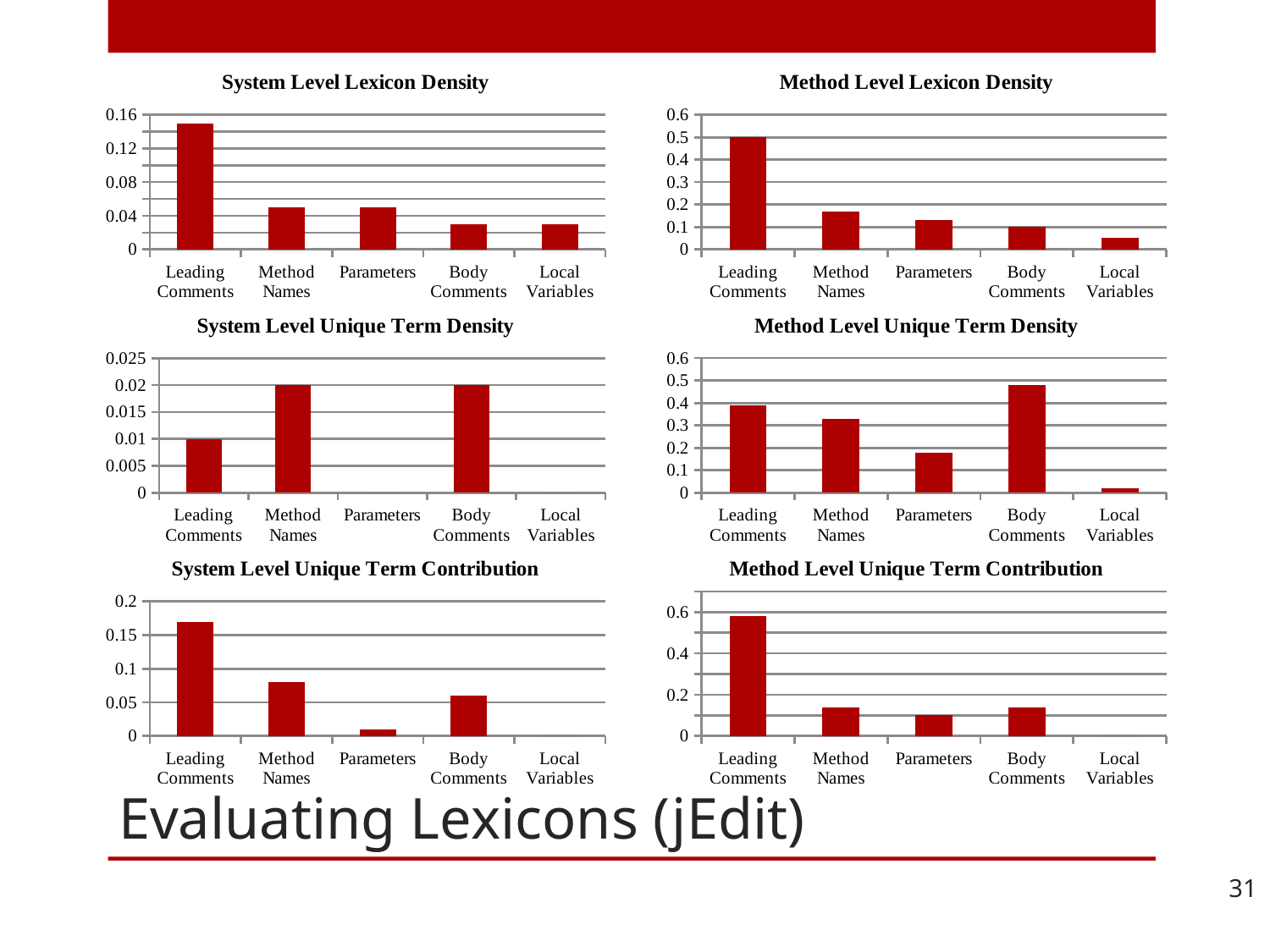
In the Method Level Unique Term Density chart, which category has the lowest value? Local Variables How many categories are shown on the x axis of the Method Level Lexicon Density chart? 5 In the System Level Unique Term Density chart, what is the difference between the values for Method Names and Leading Comments? 0.01 In the System Level Unique Term Contribution chart, is the value for Leading Comments greater or less than 0.15? greater In the Method Level Unique Term Density chart, which category has the highest value? Body Comments In the Method Level Lexicon Density chart, which category has the lowest value? Local Variables In the System Level Lexicon Density chart, which category has the highest value? Leading Comments What kind of chart is the System Level Lexicon Density chart? bar chart In the System Level Unique Term Density chart, what is the value for Leading Comments? 0.01 In the Method Level Lexicon Density chart, what is the value for Leading Comments? 0.5 In the System Level Unique Term Density chart, what is the value for Method Names? 0.02 In the Method Level Unique Term Contribution chart, which is larger, the value for Leading Comments or the value for Body Comments? Leading Comments